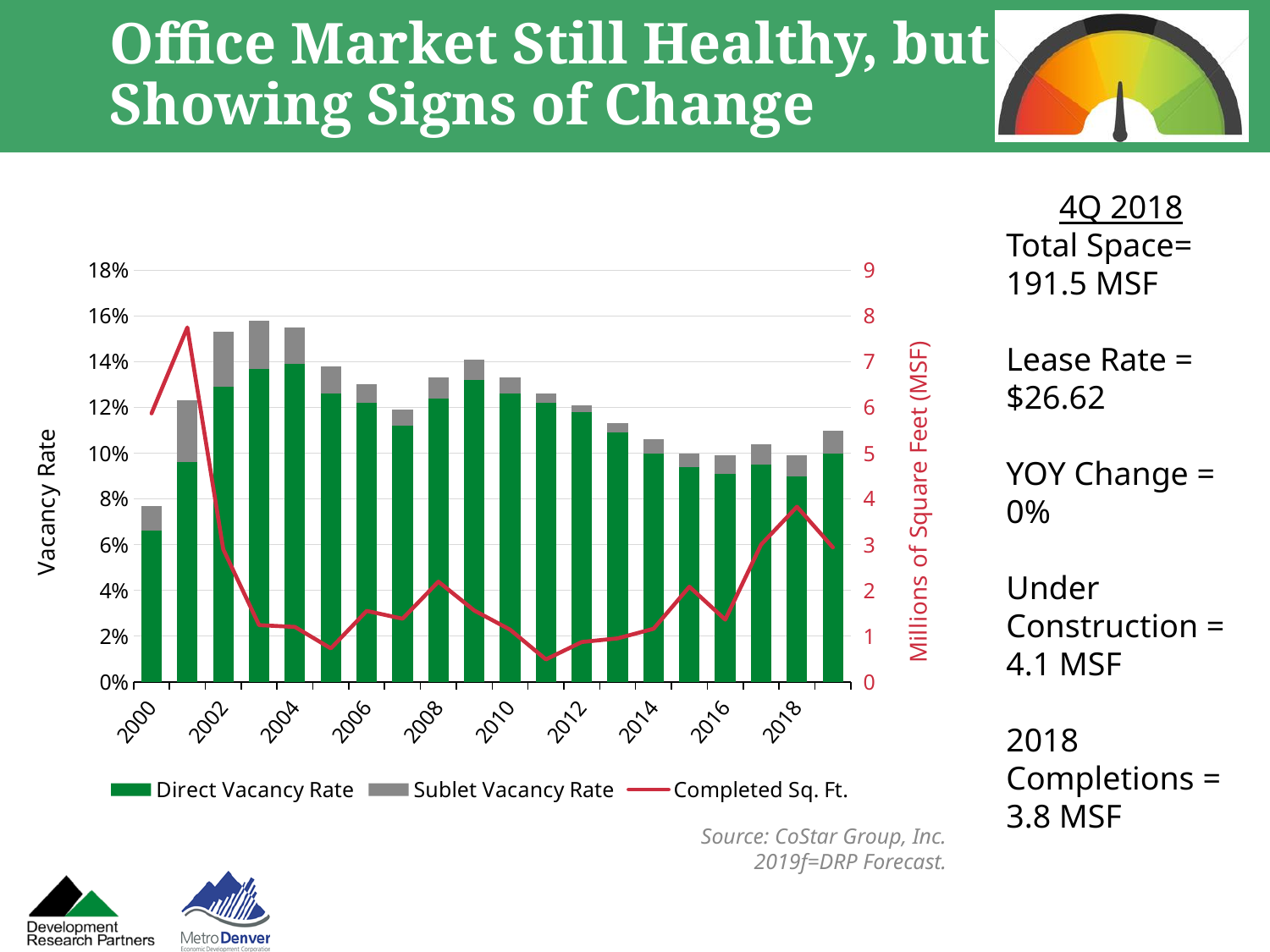
Is the Completed Sq. Ft. value for 2011 greater or less than 1 MSF? less What kind of chart is shown on the slide? A stacked bar chart with a line Is the Completed Sq. Ft. value for 2001 greater or less than 7 MSF? greater In which year does the Completed Sq. Ft. line reach its highest point? 2001 Is the Direct Vacancy Rate for 2004 greater or less than 12%? greater Which year has the lowest Direct Vacancy Rate? 2000 Does the Direct Vacancy Rate rise or fall from 2010 to 2015? fall What is the label of the right-hand vertical axis? Millions of Square Feet (MSF) How many years (bars) are plotted on the chart? 20 What are the three series listed in the chart legend? Direct Vacancy Rate, Sublet Vacancy Rate, Completed Sq. Ft. How many series does the chart legend list? 3